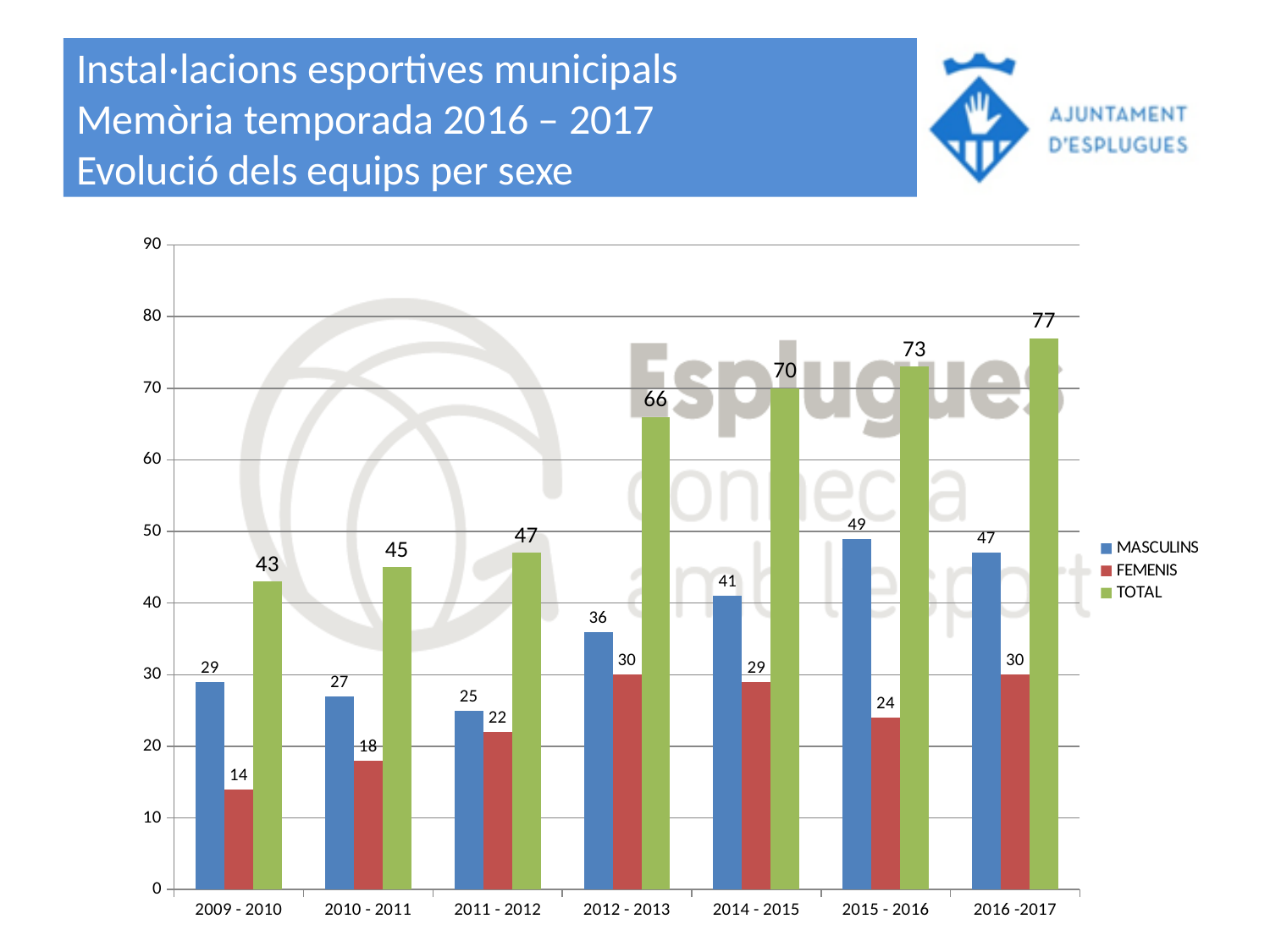
How many series does the legend list? 3 What is the FEMENIS value for 2015 - 2016? 24 Which season has the highest TOTAL value? 2016 -2017 What is the TOTAL value for 2016 -2017? 77 Which season has the lowest FEMENIS value? 2009 - 2010 Does the TOTAL series rise or fall from 2009 - 2010 to 2016 -2017? rise What is the difference between the MASCULINS and FEMENIS values in 2014 - 2015? 12 What kind of chart is shown on the slide? bar chart What is the MASCULINS value for 2012 - 2013? 36 Which is larger, the MASCULINS value for 2015 - 2016 or for 2016 -2017? 2015 - 2016 Which colour represents the FEMENIS series? red How many seasons are shown on the x axis? 7